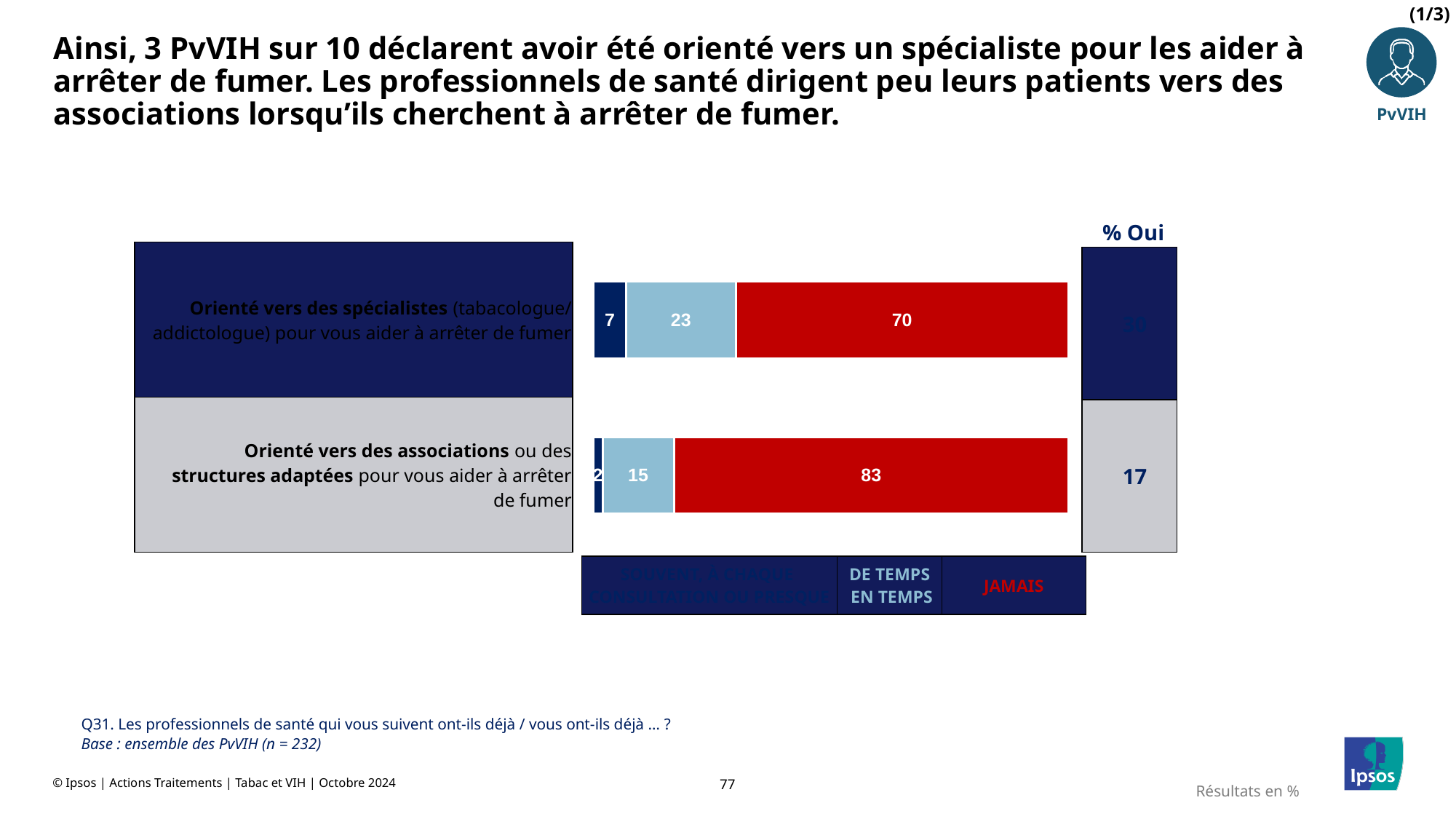
What is the 'JAMAIS' value for 'Orienté vers des associations ou des structures adaptées'? 83 What colour is the 'JAMAIS' series in the chart? Red What is the 'JAMAIS' value for 'Orienté vers des spécialistes'? 70 What is the 'DE TEMPS EN TEMPS' value for 'Orienté vers des associations ou des structures adaptées'? 15 What type of chart is shown on the slide? Stacked bar chart What is the '% Oui' value for 'Orienté vers des associations ou des structures adaptées'? 17 How many categories (rows) does the chart show? 2 Which category has the higher 'JAMAIS' value? Orienté vers des associations ou des structures adaptées How many series does the legend list? 3 What is the difference between the 'JAMAIS' values of the two categories? 13 Which is larger: the 'DE TEMPS EN TEMPS' value for 'Orienté vers des spécialistes' or for 'Orienté vers des associations'? Orienté vers des spécialistes What is the value of the dark blue segment for 'Orienté vers des spécialistes'? 7